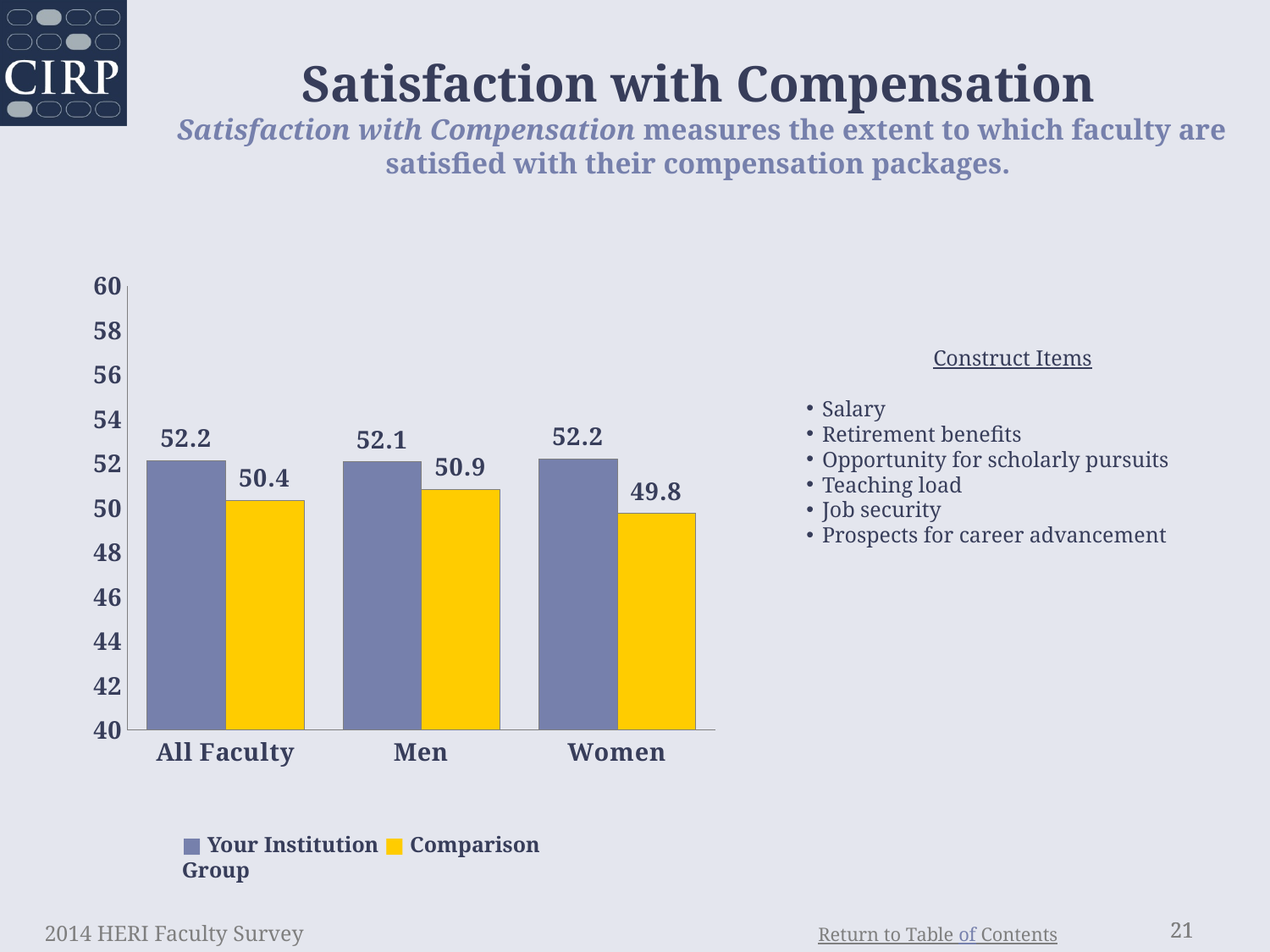
What is the difference between the Your Institution and Comparison Group values for Women? 2.4 What is the difference between the Your Institution and Comparison Group values for All Faculty? 1.8 Which category has the highest Comparison Group value? Men Which category has the lowest Comparison Group value? Women What is the Comparison Group value for Men? 50.9 What is the Your Institution value for All Faculty? 52.2 For Men, which is larger: Your Institution or Comparison Group? Your Institution How many series does the legend list? 2 How many categories are shown on the x axis? 3 What is the Your Institution value for Men? 52.1 What is the Comparison Group value for Women? 49.8 What kind of chart is shown on the slide? Bar chart